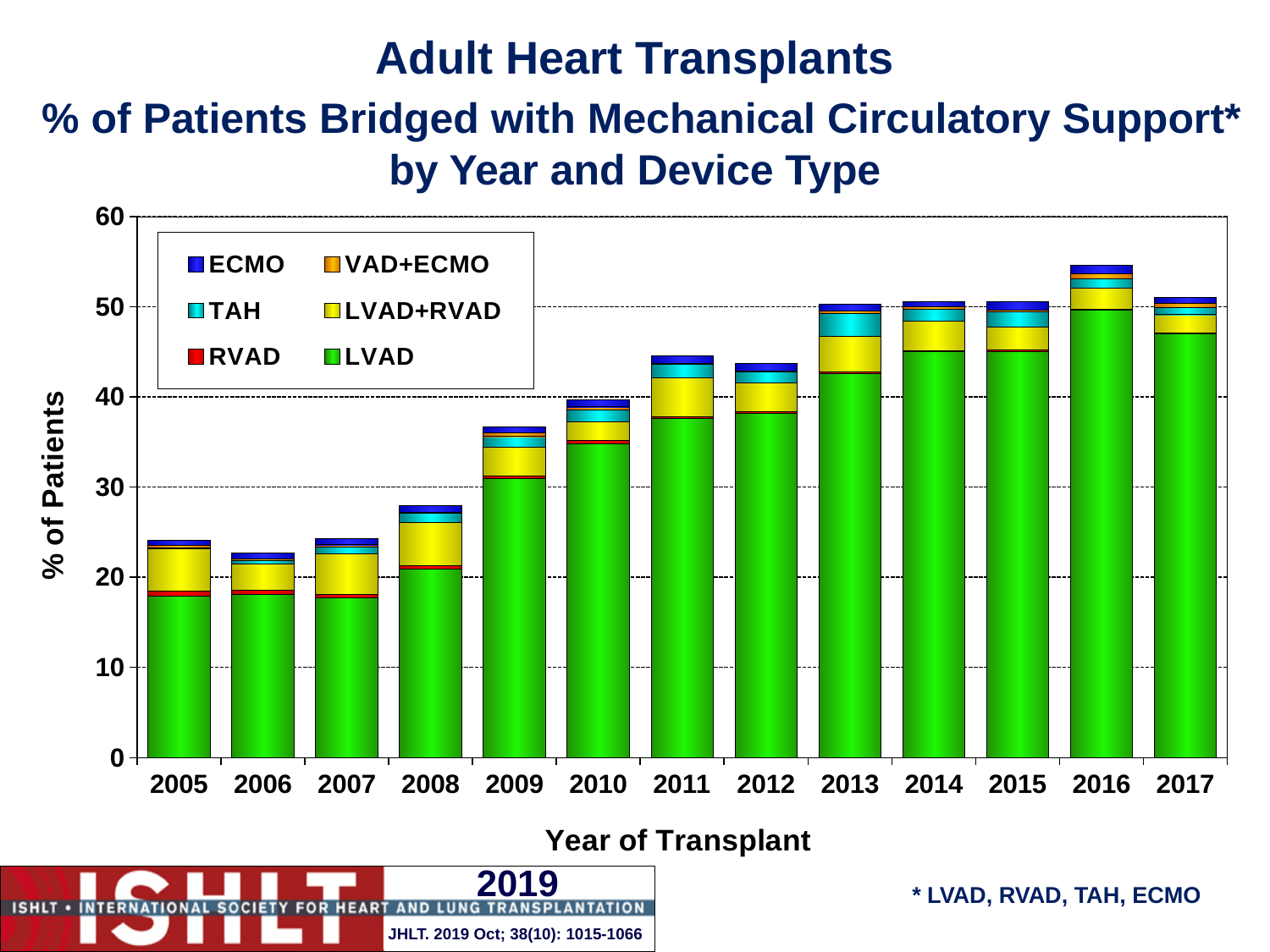
How many device types does the legend list? 6 Which year has the highest total percentage of patients bridged with mechanical circulatory support? 2016 Do the total bar heights generally rise or fall from 2007 to 2016? rise What is the title of the y axis? % of Patients Is the total value for 2016 greater or less than 50? greater Which year has a larger total bar, 2016 or 2017? 2016 How many years are shown along the x axis of the chart? 13 What kind of chart is shown on the slide? Stacked bar chart Is the total value for 2008 greater or less than 30? less Is the total value for 2009 greater or less than 30? greater Which year has the lowest total percentage of patients bridged with mechanical circulatory support? 2006